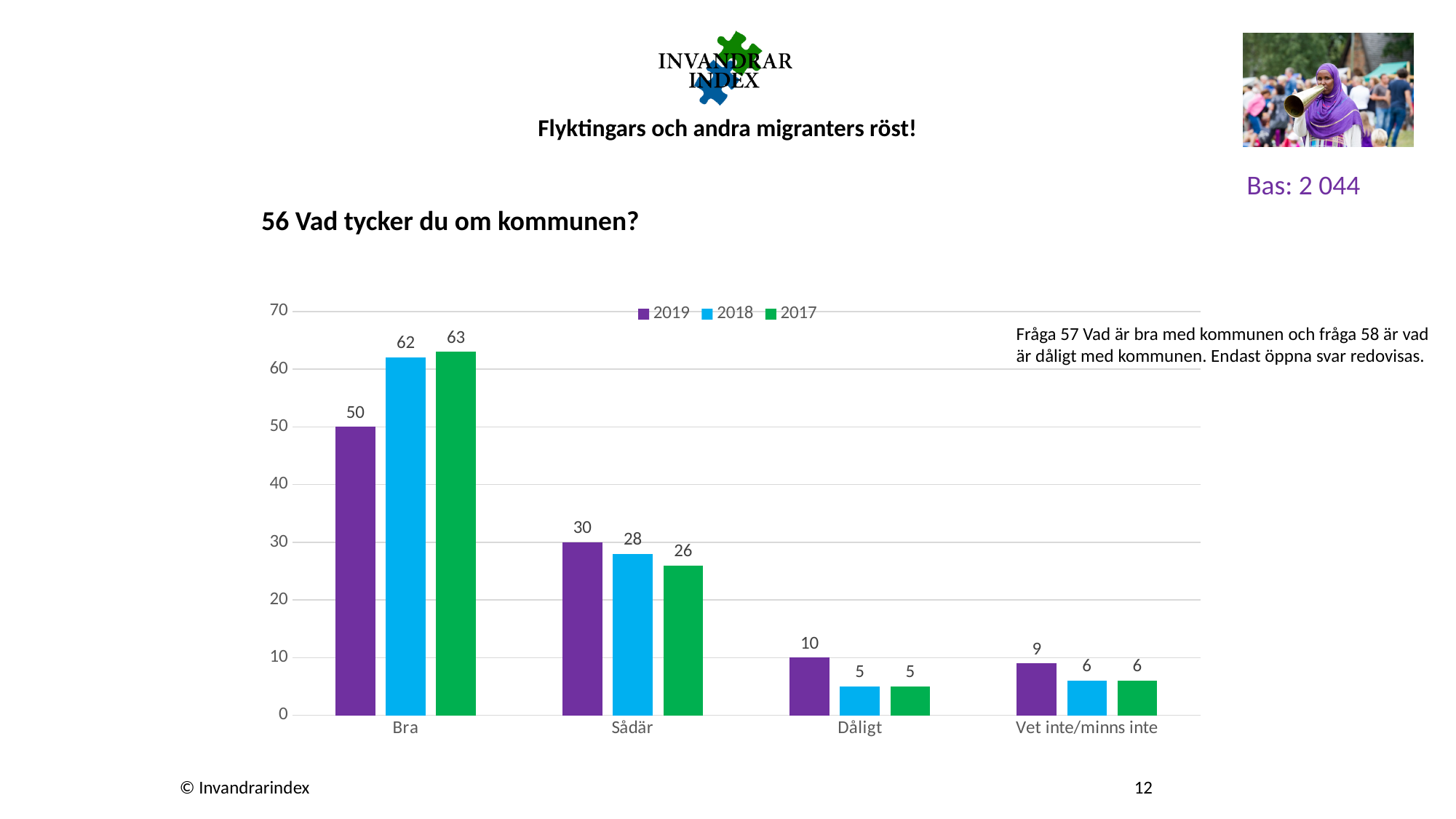
Which category has the lowest value for the 2019 series? Vet inte/minns inte In the Sådär category, which is larger: the 2019 value or the 2018 value? 2019 What is the value for 2019 in the Bra category? 50 Do the values for the 2017 series rise or fall from Bra to Dåligt along the x axis? Fall What is the difference between the 2017 and 2019 values in the Bra category? 13 What is the value for 2018 in the Dåligt category? 5 How many series does the legend list? 3 What is the value for 2017 in the Sådär category? 26 How many categories are shown on the x axis? 4 What is the title of the chart? 56 Vad tycker du om kommunen? Which category has the highest value for the 2018 series? Bra What kind of chart is shown on the slide? Bar chart